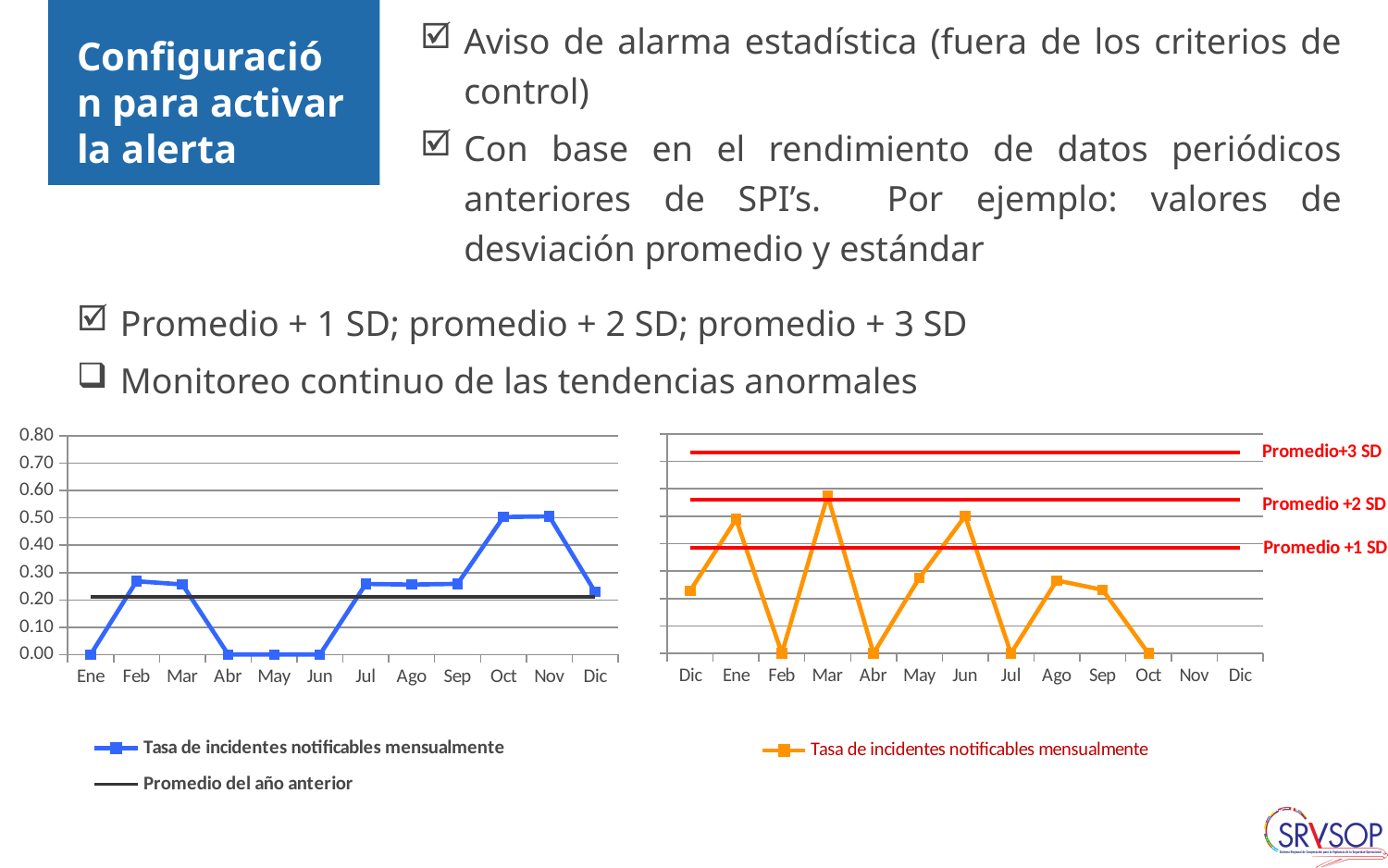
On the right chart, which month has the highest value? Mar On the right chart, what are the labels of the three red horizontal lines? Promedio+3 SD, Promedio +2 SD, Promedio +1 SD On the left chart, how many months are shown on the x axis? 12 On the right chart, how many months are shown on the x axis? 13 On the left chart, what does the legend call the black horizontal line? Promedio del año anterior On the left chart, what is the value of Tasa de incidentes notificables mensualmente for Ene? 0.00 On the left chart, which is larger, the value for Oct or the value for Jun? Oct What kind of chart is the left chart? line chart On the left chart, is the value for Feb greater or less than 0.20? greater On the left chart, what is the value of Tasa de incidentes notificables mensualmente for Abr? 0.00 On the left chart, is the value for Nov greater or less than 0.40? greater On the left chart, how many series does the legend list? 2